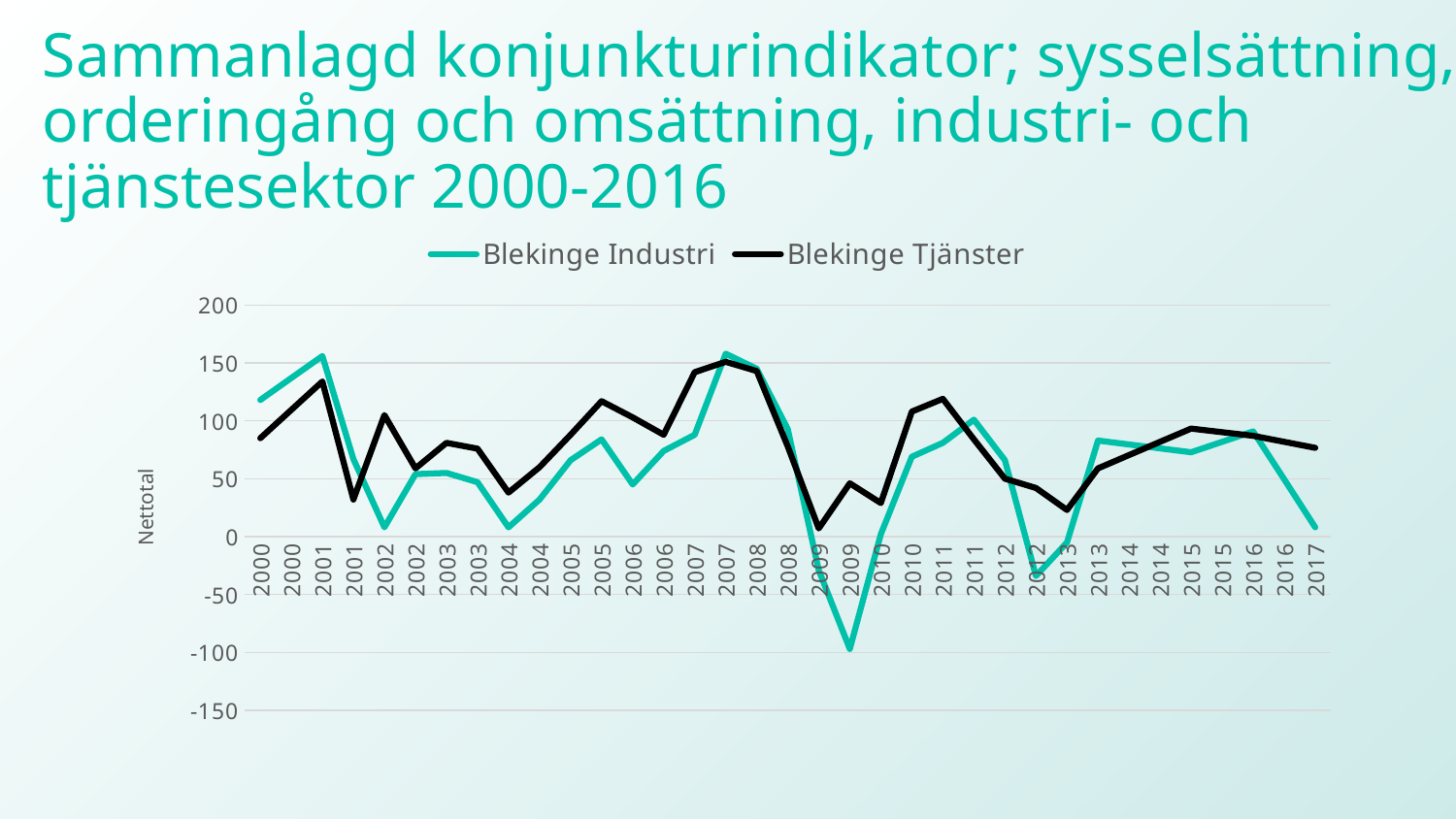
Is the lowest value of Blekinge Industri in 2009 greater or less than -50? less What is the label on the vertical axis? Nettotal How many series does the legend list? 2 Is the value for Blekinge Industri at 2017 greater or less than 50? less What are the two series named in the legend? Blekinge Industri and Blekinge Tjänster Does the Blekinge Industri line rise or fall from the last 2016 point to 2017? fall Is the value for Blekinge Tjänster at the first 2000 point greater or less than 50? greater What kind of chart is shown on the slide? line chart At 2017, which series has the higher value, Blekinge Industri or Blekinge Tjänster? Blekinge Tjänster Which series reaches the lowest value anywhere on the chart? Blekinge Industri At the second 2009 point, which series has the higher value, Blekinge Industri or Blekinge Tjänster? Blekinge Tjänster